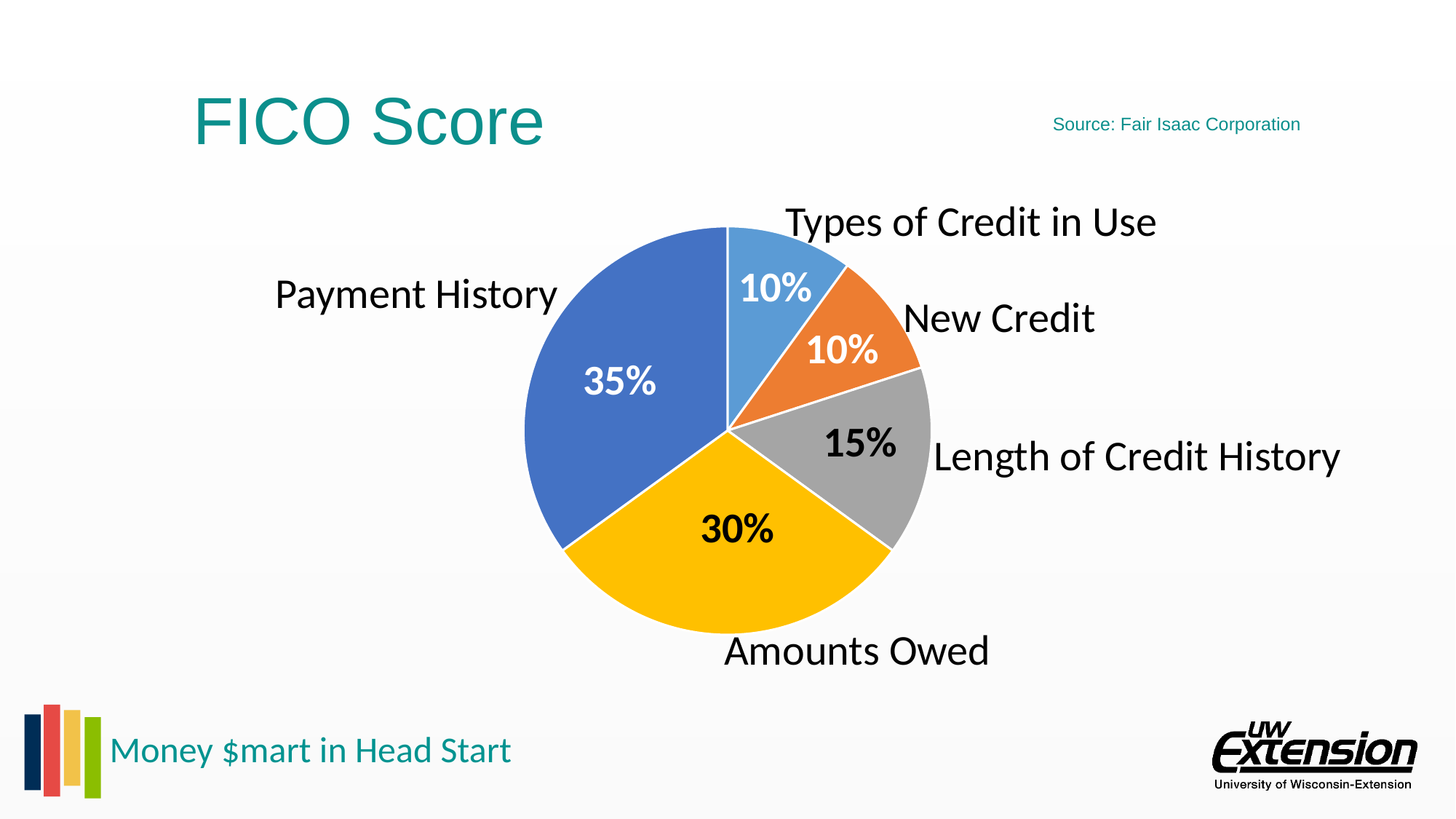
What share of the FICO Score does Amounts Owed account for? 30% What type of chart is shown on the slide? Pie chart How many slices does the pie chart have? 5 What is the difference in percentage points between Amounts Owed and Length of Credit History? 15% What share of the FICO Score does Payment History account for? 35% Which is larger, Length of Credit History or Types of Credit in Use? Length of Credit History What is the difference in percentage points between Payment History and Amounts Owed? 5% What colour is the Amounts Owed slice? Yellow What share of the FICO Score does New Credit account for? 10% What is the title of the slide containing the pie chart? FICO Score Which category has the largest slice of the pie? Payment History What share of the FICO Score does Length of Credit History account for? 15%